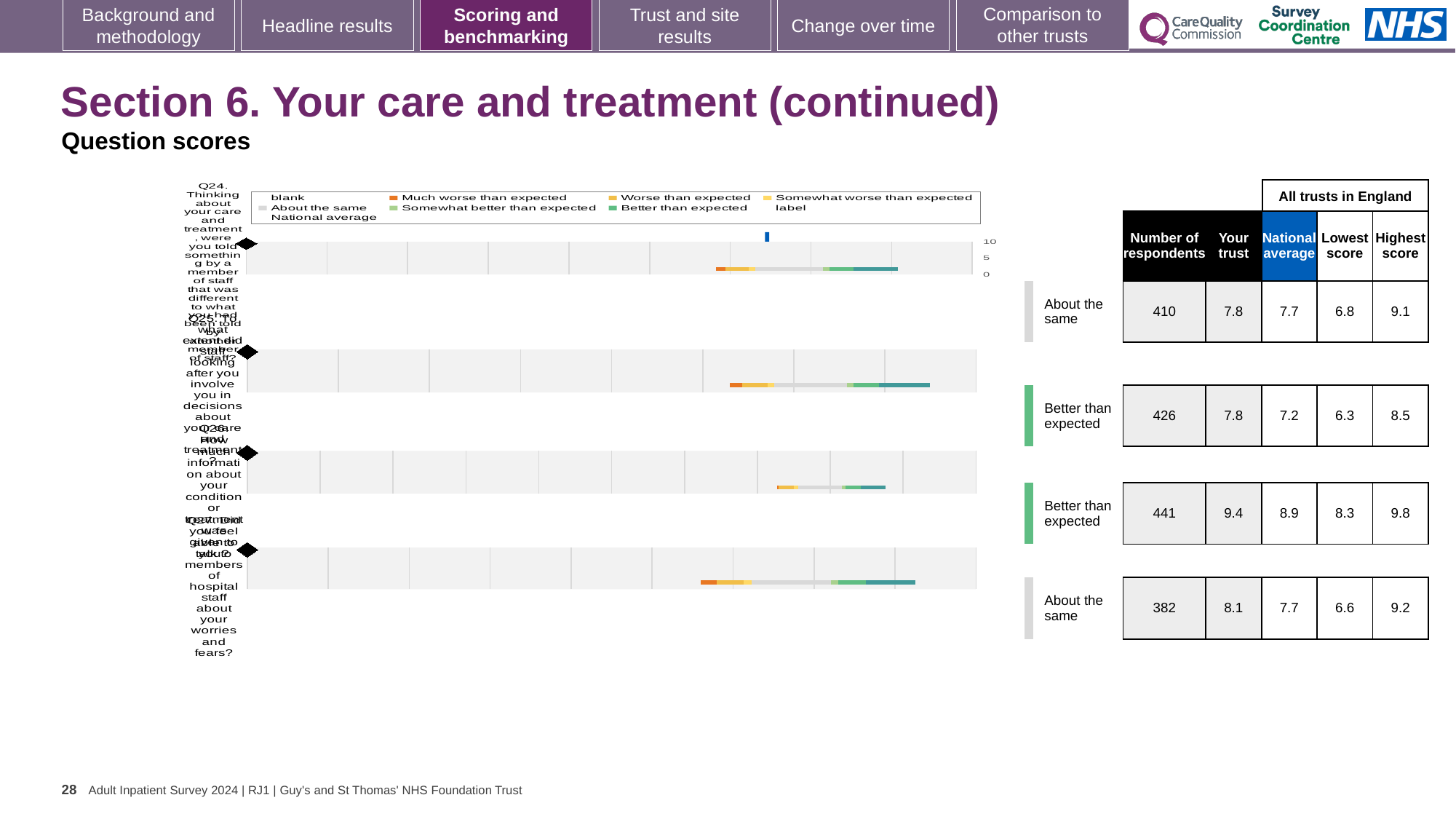
What is the highest value shown on the score axis of the top chart? 10 In the chart legend, what colour represents 'About the same'? grey For the top chart row, what is the number of respondents shown in the table? 410 How many question charts (rows) are shown on the slide? 4 For the bottom chart row, which is larger: the 'Your trust' score or the national average? Your trust (8.1) What benchmark category is shown for the bottom chart row? About the same For the second chart row, what is the highest score among all trusts in England? 8.5 For the third chart row, what is the difference between the 'Your trust' score and the national average? 0.5 What kind of chart is used to show the question scores on this slide? bar chart For the third chart row, what is the national average score? 8.9 For the second chart row, what is the 'Your trust' score? 7.8 Which chart row has the highest 'Your trust' score? the third row (9.4)